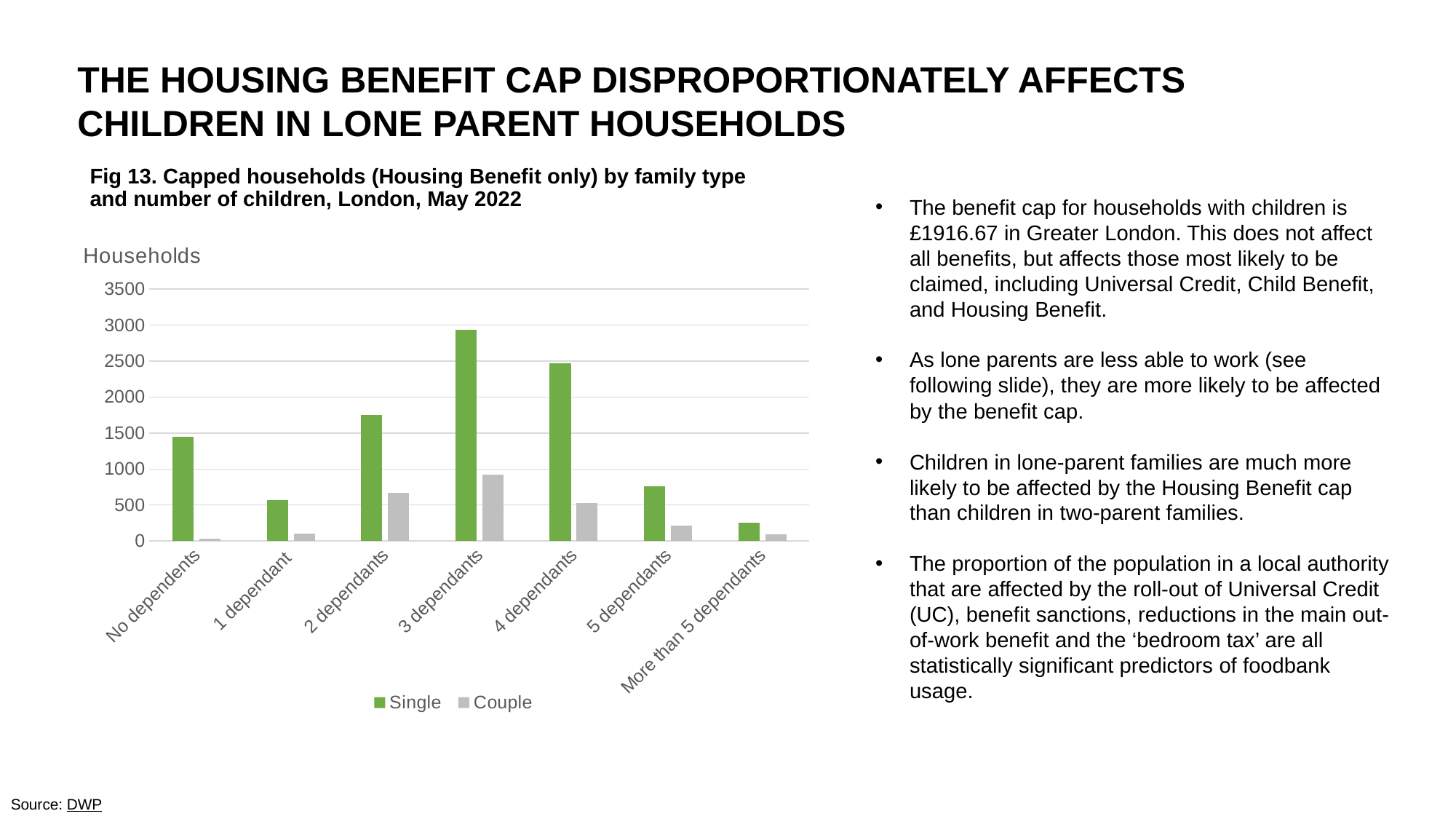
What label is shown on the vertical axis of the chart? Households Which series is larger for 5 dependants, Single or Couple? Single Which category has the highest value for the Single series? 3 dependants Which category has the highest value for the Couple series? 3 dependants Is the Single value for No dependents greater or less than 1000? greater How many family-size categories are shown on the x axis? 7 Is the Single value for 3 dependants greater or less than 2500? greater What kind of chart is shown on the slide? Bar chart Which category has the lowest value for the Single series? More than 5 dependants Is the Couple value for 3 dependants greater or less than 1000? less How many series does the legend list? 2 Which is larger for the Single series: 2 dependants or 4 dependants? 4 dependants